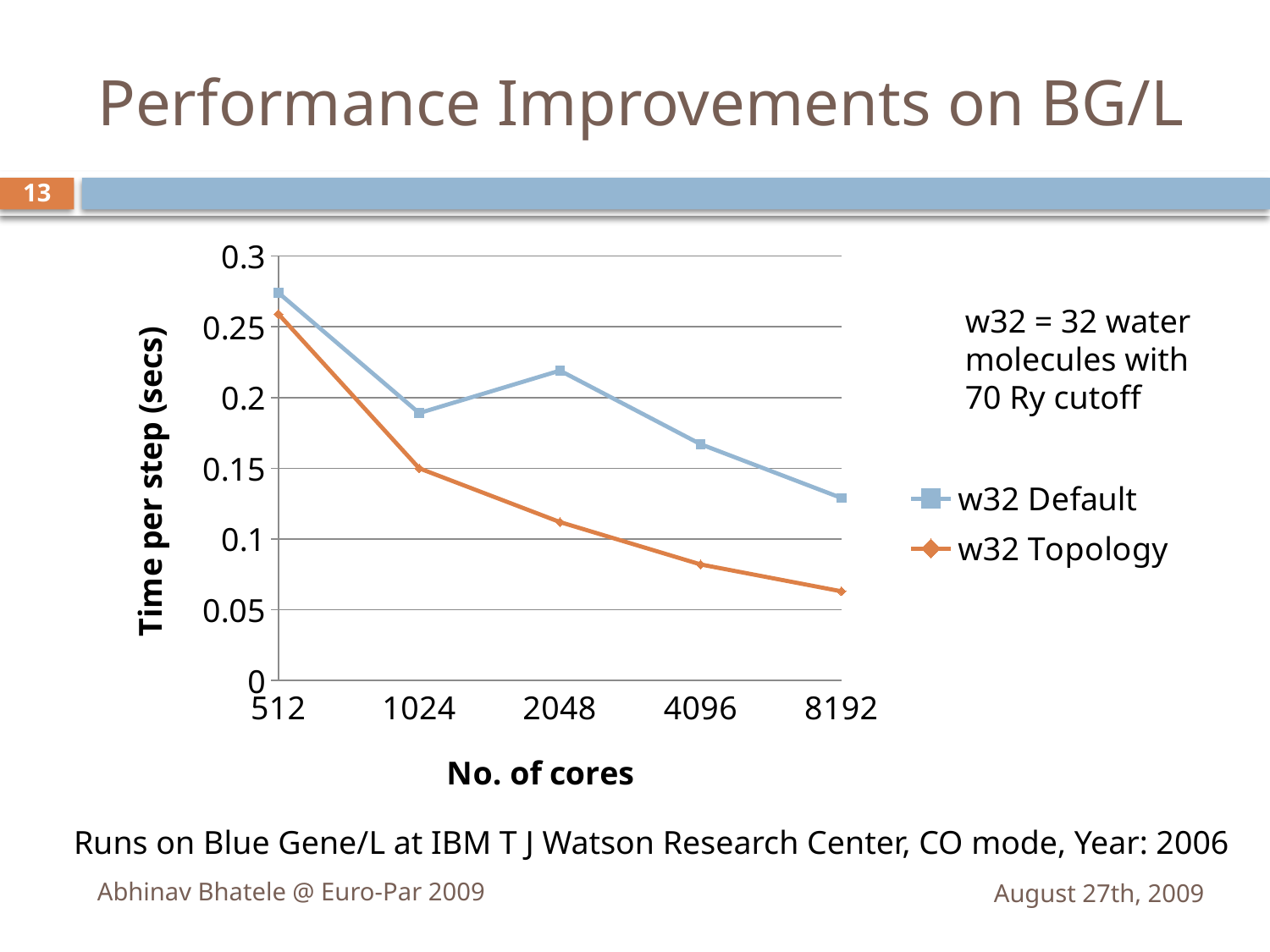
How many core counts are plotted along the x axis? 5 Is the time per step for w32 Default at 512 cores greater or less than 0.25? greater At 2048 cores, which series has the larger time per step, w32 Default or w32 Topology? w32 Default How many series does the legend list? 2 What is the label on the x axis of the chart? No. of cores Is the time per step for w32 Default at 8192 cores greater or less than 0.15? less Is the time per step for w32 Topology at 8192 cores greater or less than 0.1? less At which number of cores is the time per step for w32 Topology lowest? 8192 What is the label on the y axis of the chart? Time per step (secs) Does the time per step for w32 Topology rise or fall as the number of cores increases? fall At which number of cores is the time per step for w32 Default highest? 512 What kind of chart is shown on the slide? line chart